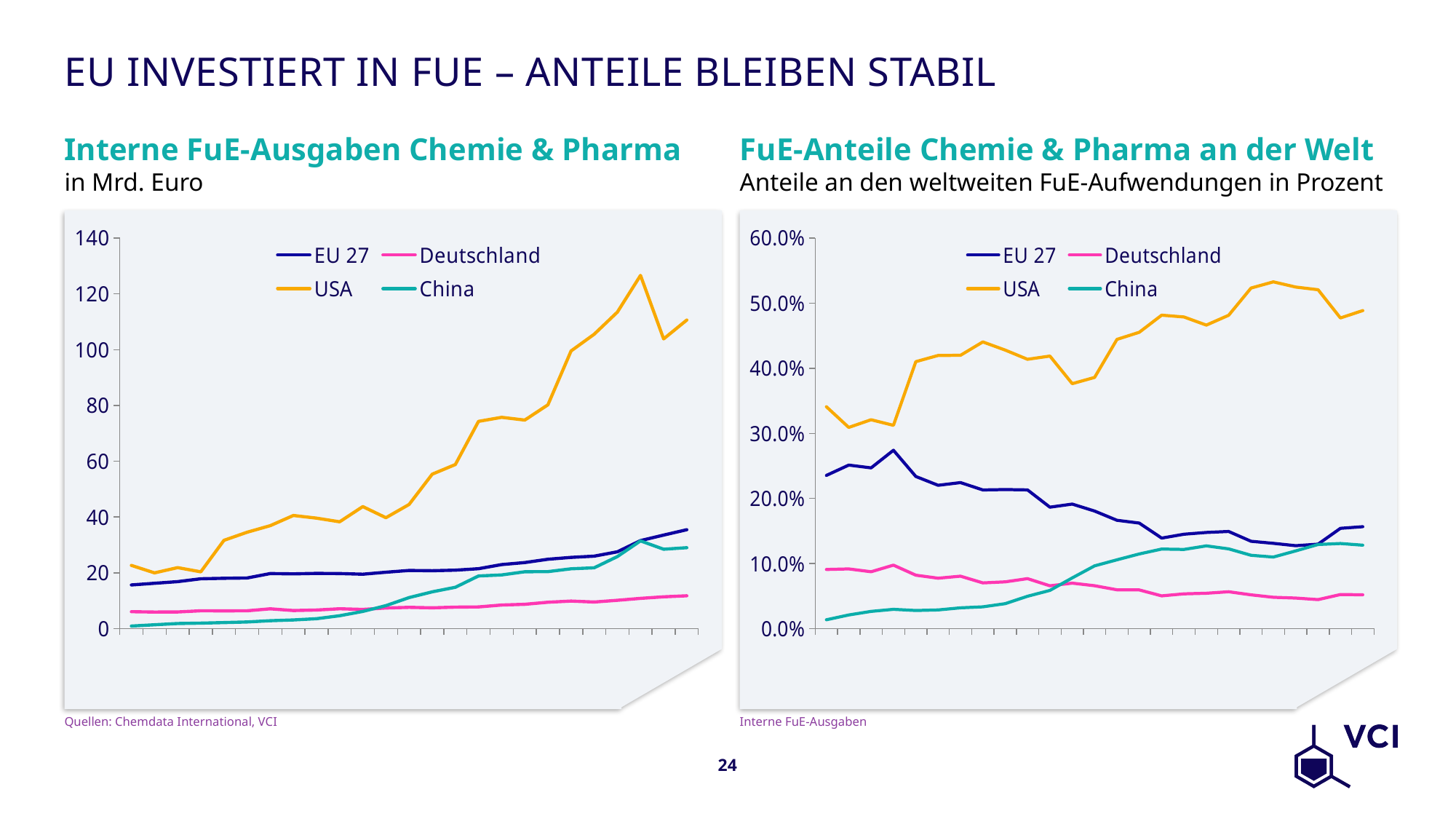
In the right chart, 'FuE-Anteile Chemie & Pharma an der Welt', does the EU 27 line overall rise or fall along the x axis? fall What kind of chart is the left chart, 'Interne FuE-Ausgaben Chemie & Pharma'? Line chart In the left chart, 'Interne FuE-Ausgaben Chemie & Pharma', which series has the lowest values at the right end of the x axis? Deutschland In the left chart, 'Interne FuE-Ausgaben Chemie & Pharma', is the first value of the China line greater or less than 20? less In the right chart, 'FuE-Anteile Chemie & Pharma an der Welt', at the left end of the x axis, which is larger: the EU 27 share or the Deutschland share? EU 27 What unit is given in the subtitle of the left chart, 'Interne FuE-Ausgaben Chemie & Pharma'? in Mrd. Euro In the left chart, 'Interne FuE-Ausgaben Chemie & Pharma', is the peak value of the USA line greater or less than 120? greater In the right chart, 'FuE-Anteile Chemie & Pharma an der Welt', is the last value of the USA line greater or less than 40.0%? greater In the right chart, 'FuE-Anteile Chemie & Pharma an der Welt', does the China line overall rise or fall along the x axis? rise How many series does the legend of the right chart, 'FuE-Anteile Chemie & Pharma an der Welt', list? 4 In the left chart, 'Interne FuE-Ausgaben Chemie & Pharma', which series has the highest values at the right end of the x axis? USA In the right chart, 'FuE-Anteile Chemie & Pharma an der Welt', which series has the highest share at the right end of the x axis? USA